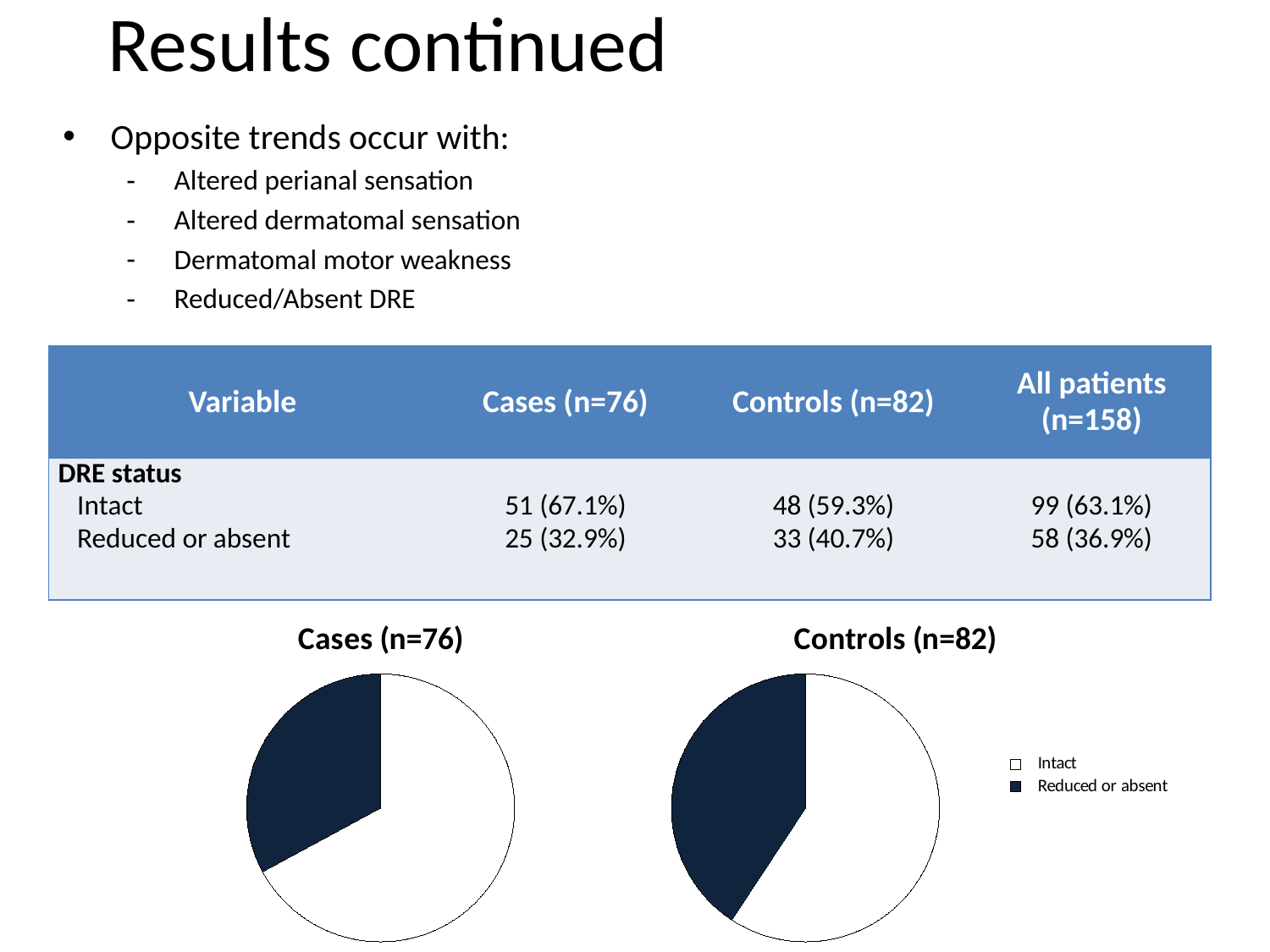
What colour is the Reduced or absent slice in the pie charts? dark navy blue In the "Cases (n=76)" pie chart, which slice is larger, Intact or Reduced or absent? Intact In the "Cases (n=76)" pie chart, which category has the smallest slice? Reduced or absent According to the table, what share of the "Cases (n=76)" pie chart is Intact? 67.1% How many entries does the legend list for the pie charts? 2 What is the title of the pie chart on the right? Controls (n=82) According to the table, what share of the "Controls (n=82)" pie chart is Reduced or absent? 40.7% How many slices does the "Cases (n=76)" pie chart have? 2 What kind of chart is the "Cases (n=76)" chart? pie chart In the "Controls (n=82)" pie chart, which category has the largest slice? Intact What kind of chart is the "Controls (n=82)" chart? pie chart In the "Controls (n=82)" pie chart, which slice is larger, Intact or Reduced or absent? Intact